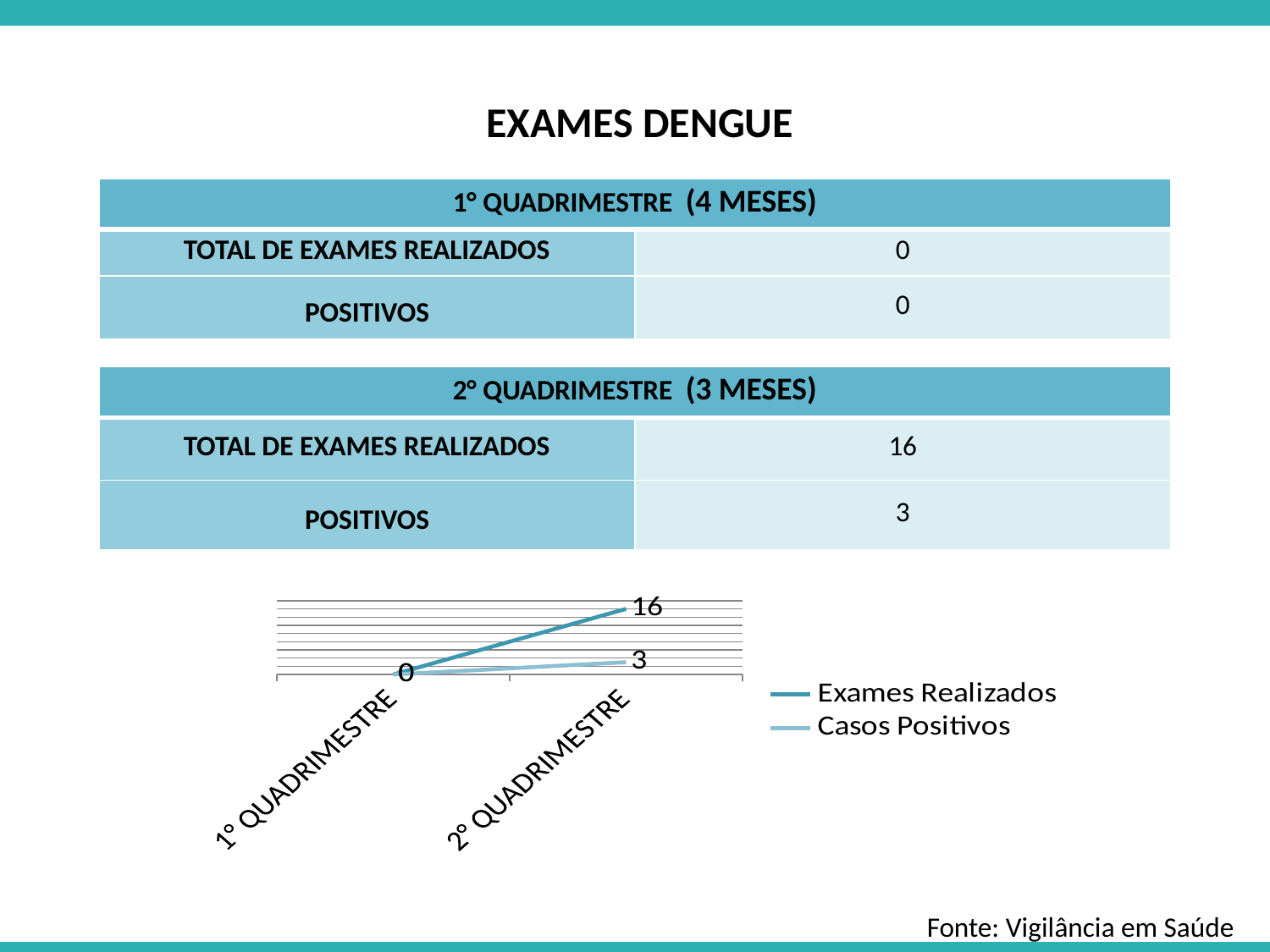
How many categories are shown on the x axis of the chart? 2 What are the two series names listed in the chart legend? Exames Realizados, Casos Positivos What is the value of Casos Positivos for 2° QUADRIMESTRE in the chart? 3 What is the value of Exames Realizados for 1° QUADRIMESTRE in the chart? 0 What kind of chart is shown on the slide? line chart How many series does the chart legend list? 2 What is the title shown above the tables and chart on the slide? EXAMES DENGUE What is the value of Exames Realizados for 2° QUADRIMESTRE in the chart? 16 What is the difference between Exames Realizados and Casos Positivos for 2° QUADRIMESTRE in the chart? 13 Does the Exames Realizados line rise or fall from 1° QUADRIMESTRE to 2° QUADRIMESTRE? rise Which series has the higher value for 2° QUADRIMESTRE in the chart? Exames Realizados Which category has the highest value for Exames Realizados in the chart? 2° QUADRIMESTRE